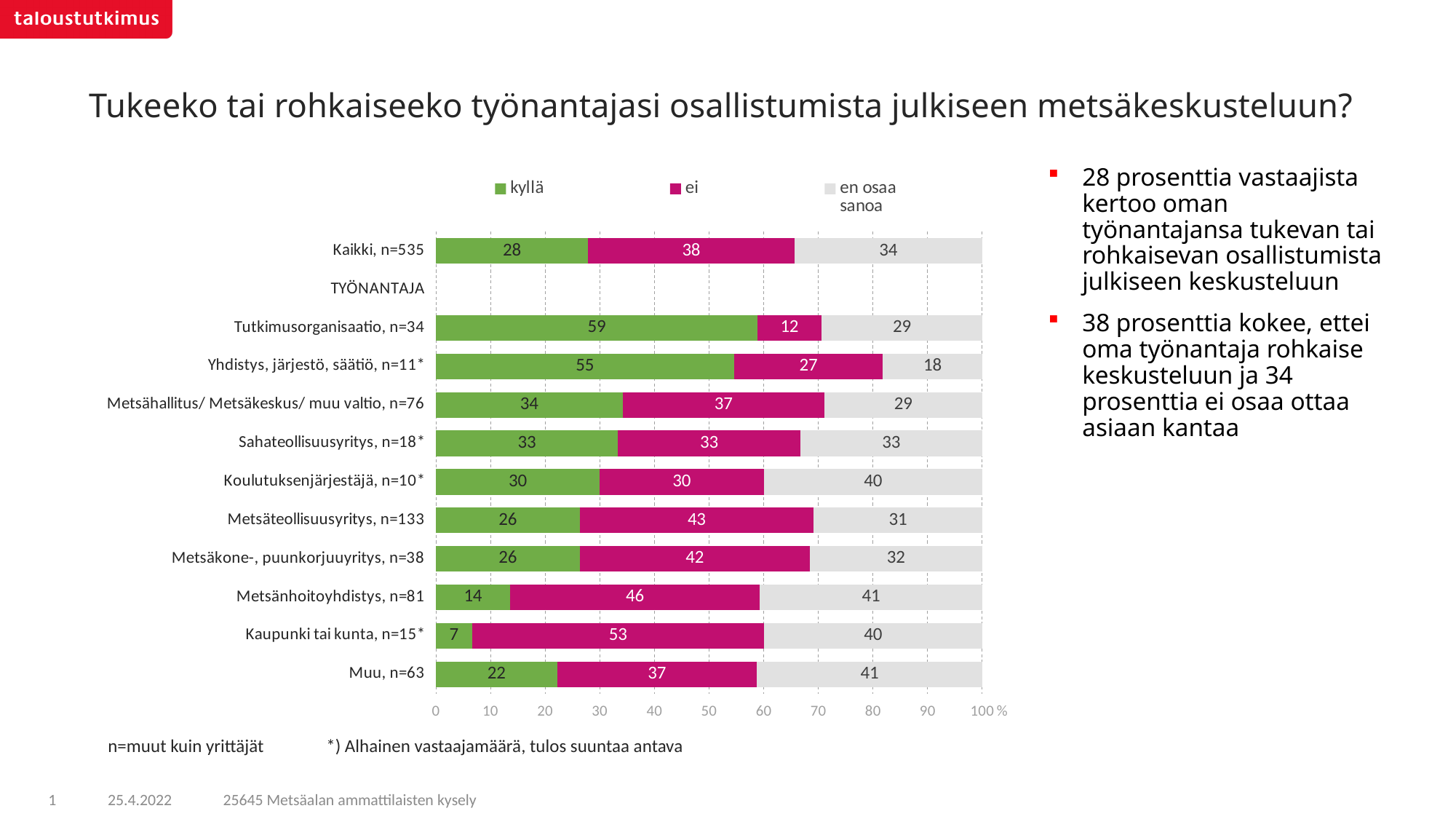
What is the total of the stacked bar for Muu, n=63? 100 How many series does the legend list? 3 What is the 'kyllä' value for Kaikki, n=535? 28 Which category has the highest 'ei' value? Kaupunki tai kunta, n=15* How many bars (categories with data) are plotted in the chart? 11 Which is larger: the 'kyllä' value for Yhdistys, järjestö, säätiö, n=11* or the 'kyllä' value for Metsähallitus/ Metsäkeskus/ muu valtio, n=76? Yhdistys, järjestö, säätiö, n=11* What is the difference between the 'ei' value for Metsäteollisuusyritys, n=133 and the 'ei' value for Tutkimusorganisaatio, n=34? 31 What is the 'ei' value for Metsänhoitoyhdistys, n=81? 46 Which category has the lowest 'kyllä' value? Kaupunki tai kunta, n=15* What is the 'en osaa sanoa' value for Koulutuksenjärjestäjä, n=10*? 40 What kind of chart is shown on the slide? Stacked bar chart Which category has the highest 'kyllä' value? Tutkimusorganisaatio, n=34